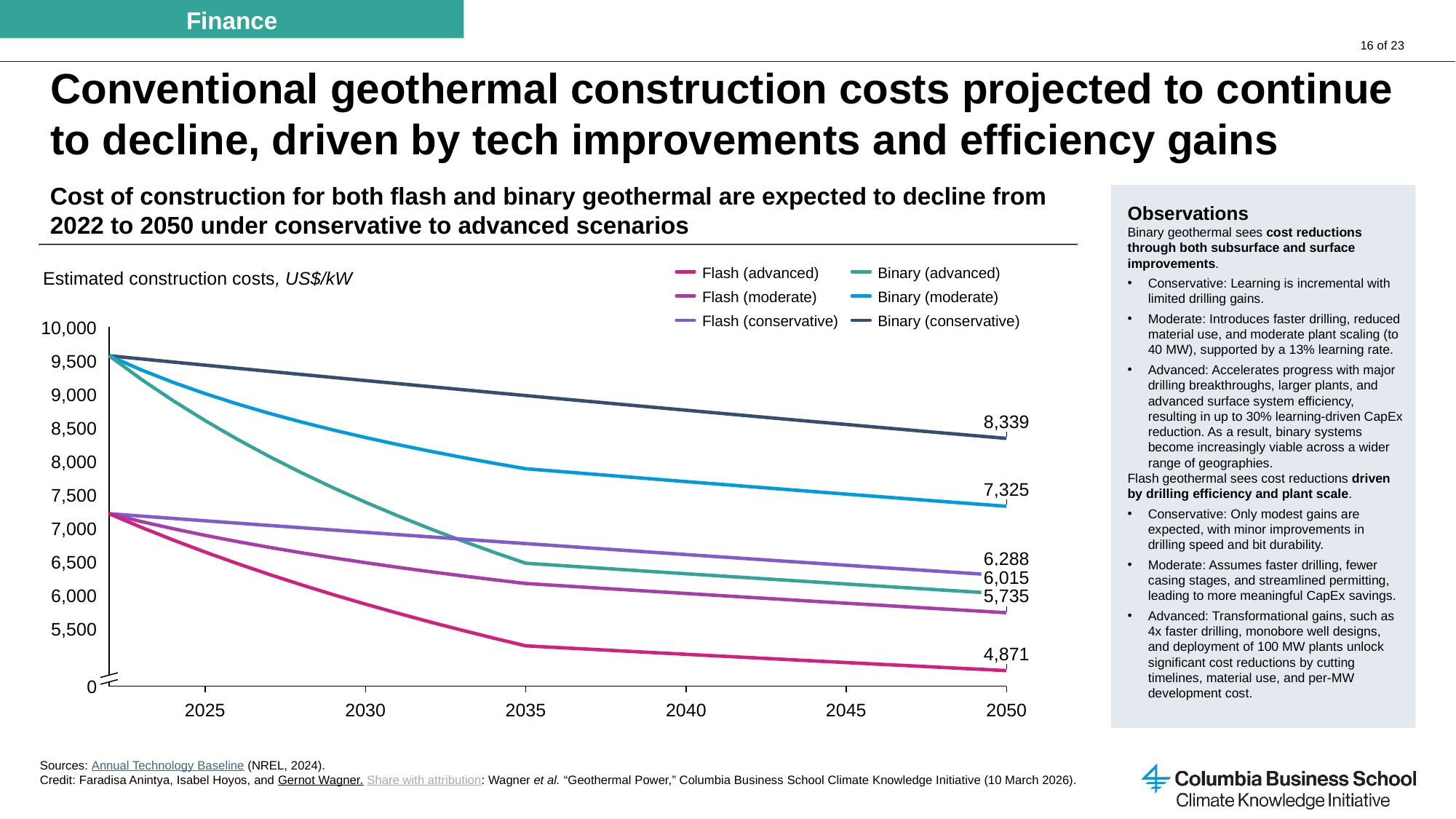
What is the estimated construction cost for Binary (moderate) in 2050? 7,325 What is the difference between the 2050 construction costs of Binary (conservative) and Flash (advanced)? 3,468 How many series does the legend list? 6 What is the estimated construction cost for Flash (advanced) in 2050? 4,871 What is the estimated construction cost for Binary (conservative) in 2050? 8,339 Which series has the lowest estimated construction cost in 2050? Flash (advanced) Do the estimated construction costs rise or fall from 2022 to 2050? Fall In 2050, which is larger: the construction cost for Binary (advanced) or Flash (moderate)? Binary (advanced) What is the estimated construction cost for Flash (conservative) in 2050? 6,288 Is the value for Binary (moderate) in 2035 greater or less than 8,000? less Which series has the highest estimated construction cost in 2050? Binary (conservative) What kind of chart is shown on the slide? Line chart